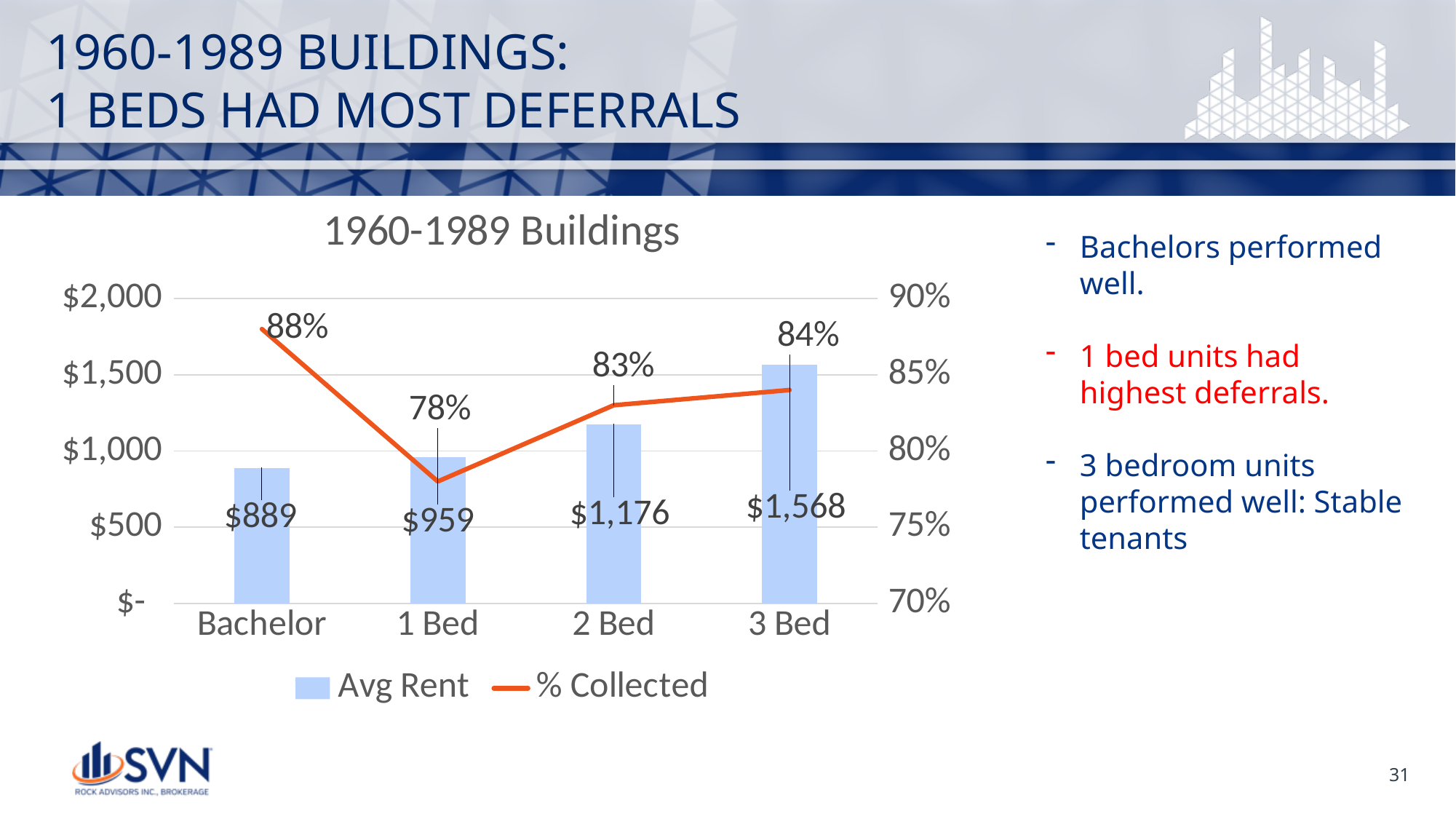
How many series does the legend list? 2 What is the % Collected for Bachelor units? 88% How many unit types are shown on the x axis? 4 Which has a higher % Collected, 2 Bed or 3 Bed? 3 Bed What is the difference in % Collected between Bachelor and 1 Bed units? 10% What is the title of the chart? 1960-1989 Buildings What is the Avg Rent for 3 Bed units? $1,568 What is the Avg Rent for 1 Bed units? $959 Which unit type has the lowest % Collected? 1 Bed What is the difference in Avg Rent between 3 Bed and 2 Bed units? $392 Does Avg Rent rise or fall from Bachelor to 3 Bed? rise Which unit type has the highest Avg Rent? 3 Bed